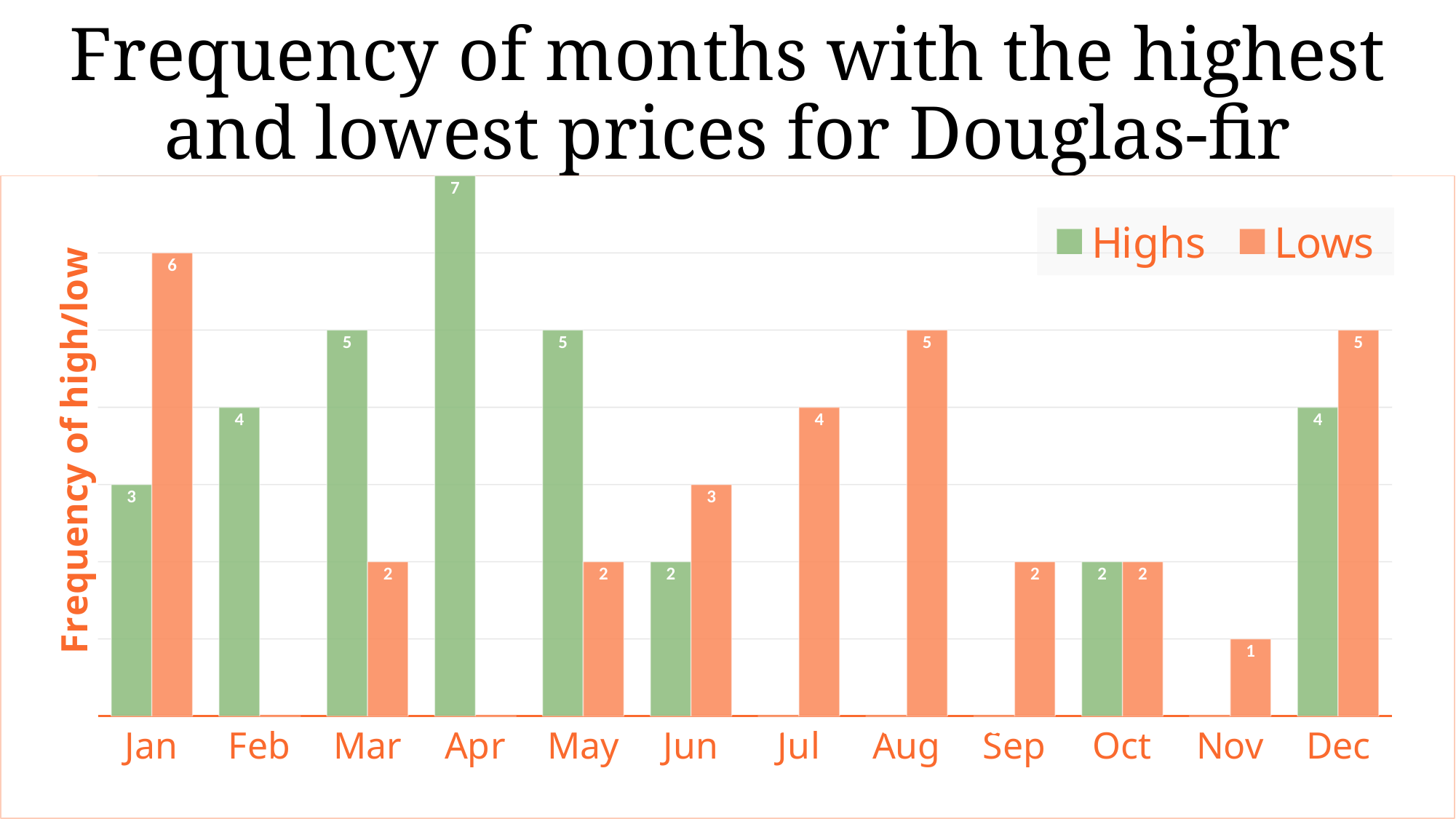
Which month has the lowest Lows value among the months with a Lows bar? Nov How many series does the legend list? 2 How many months are shown on the x axis? 12 Which month has the highest Lows value? Jan What is the difference between the Highs value for April and the Highs value for January? 4 Which month has the highest Highs value? Apr What is the Highs value for December? 4 What is the Highs value for April? 7 What is the Lows value for January? 6 What kind of chart is shown on the slide? Bar chart What is the Lows value for November? 1 Which is larger for June, the Highs value or the Lows value? Lows